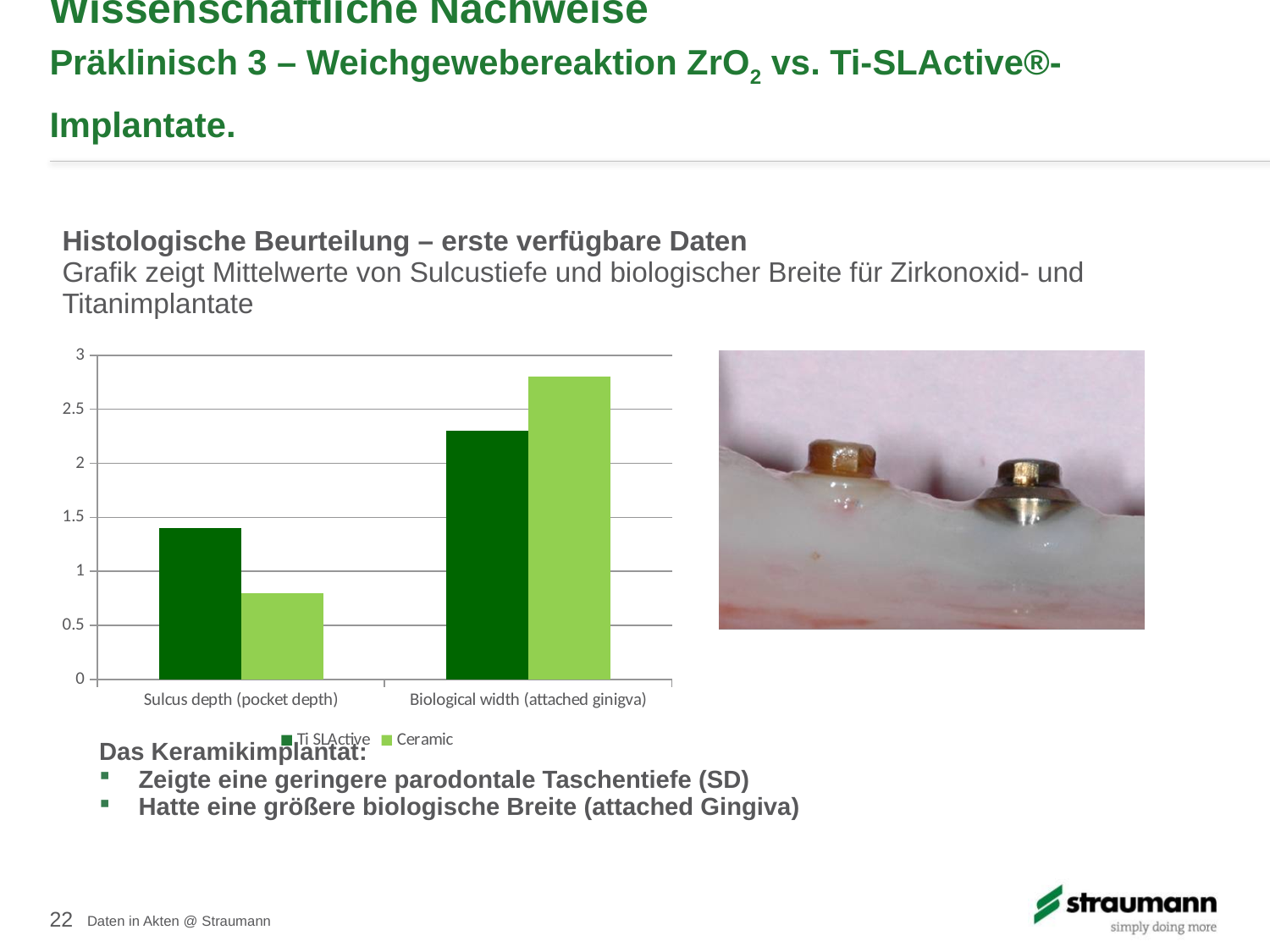
How many series does the chart legend list? 2 Which series is shown in dark green in the chart? Ti SLActive Is the Ti SLActive value for Biological width (attached ginigva) greater or less than 2.5? less Which series is shown in light green in the chart? Ceramic What kind of chart is shown on the slide? bar chart Is the Ceramic value for Biological width (attached ginigva) greater or less than 2.5? greater For Sulcus depth (pocket depth), which series has the larger value, Ti SLActive or Ceramic? Ti SLActive How many categories are shown on the x axis of the chart? 2 Is the Ceramic value for Sulcus depth (pocket depth) greater or less than 1? less Which bar in the chart is the tallest? Ceramic, Biological width (attached ginigva) For Biological width (attached ginigva), which series has the larger value, Ti SLActive or Ceramic? Ceramic